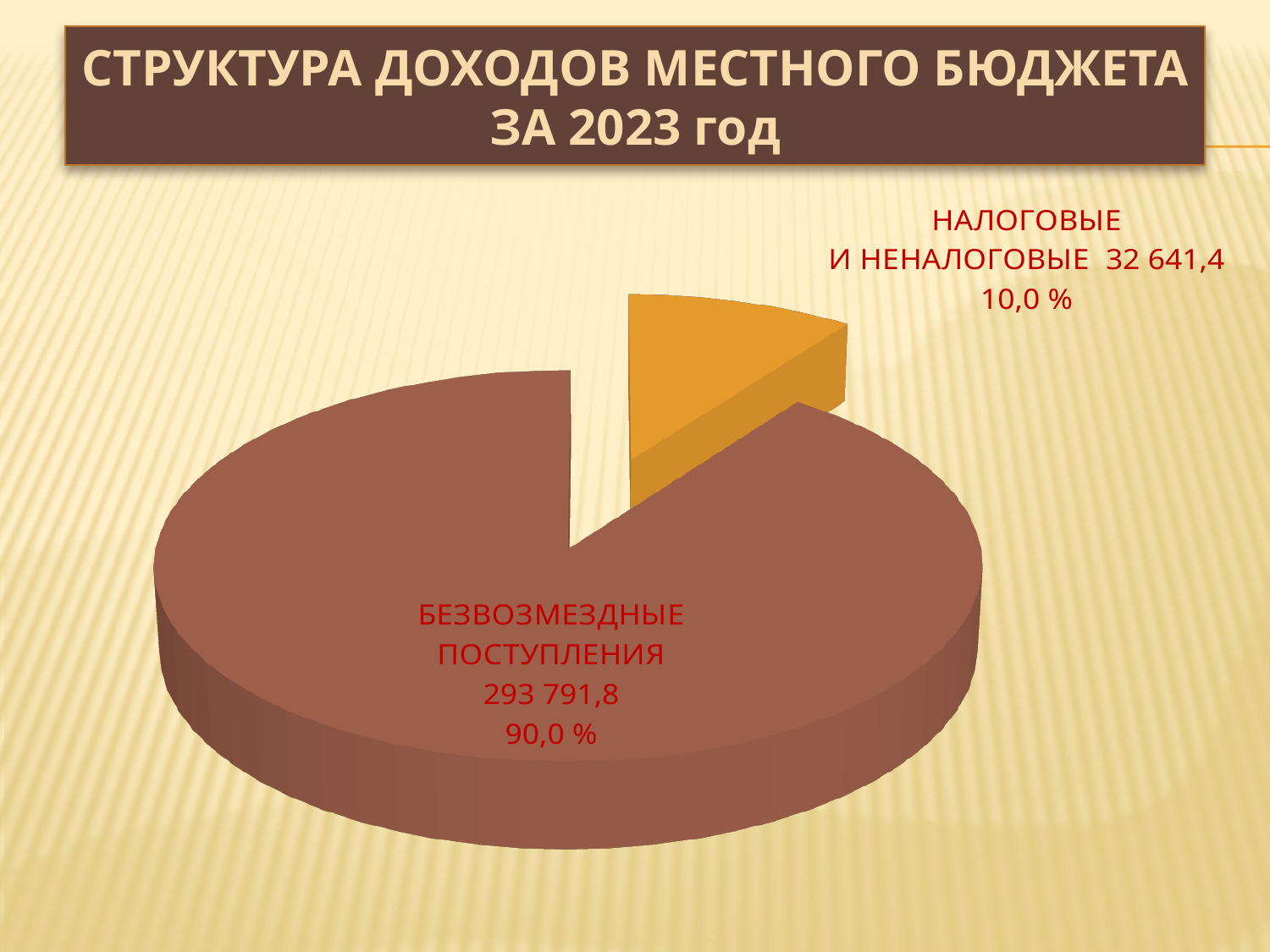
What kind of chart is shown on the slide? pie chart Which category has the largest slice of the pie? БЕЗВОЗМЕЗДНЫЕ ПОСТУПЛЕНИЯ What share of the pie does НАЛОГОВЫЕ И НЕНАЛОГОВЫЕ represent? 10,0 % Which category has the smallest slice of the pie? НАЛОГОВЫЕ И НЕНАЛОГОВЫЕ Which is larger, БЕЗВОЗМЕЗДНЫЕ ПОСТУПЛЕНИЯ or НАЛОГОВЫЕ И НЕНАЛОГОВЫЕ? БЕЗВОЗМЕЗДНЫЕ ПОСТУПЛЕНИЯ What share of the pie does БЕЗВОЗМЕЗДНЫЕ ПОСТУПЛЕНИЯ represent? 90,0 % What is the title of the slide containing the chart? СТРУКТУРА ДОХОДОВ МЕСТНОГО БЮДЖЕТА ЗА 2023 год What is the value for НАЛОГОВЫЕ И НЕНАЛОГОВЫЕ? 32 641,4 What is the difference in percentage share between БЕЗВОЗМЕЗДНЫЕ ПОСТУПЛЕНИЯ and НАЛОГОВЫЕ И НЕНАЛОГОВЫЕ? 80,0 % What colour is the slice for НАЛОГОВЫЕ И НЕНАЛОГОВЫЕ? orange How many slices does the pie chart have? 2 What is the value for БЕЗВОЗМЕЗДНЫЕ ПОСТУПЛЕНИЯ? 293 791,8